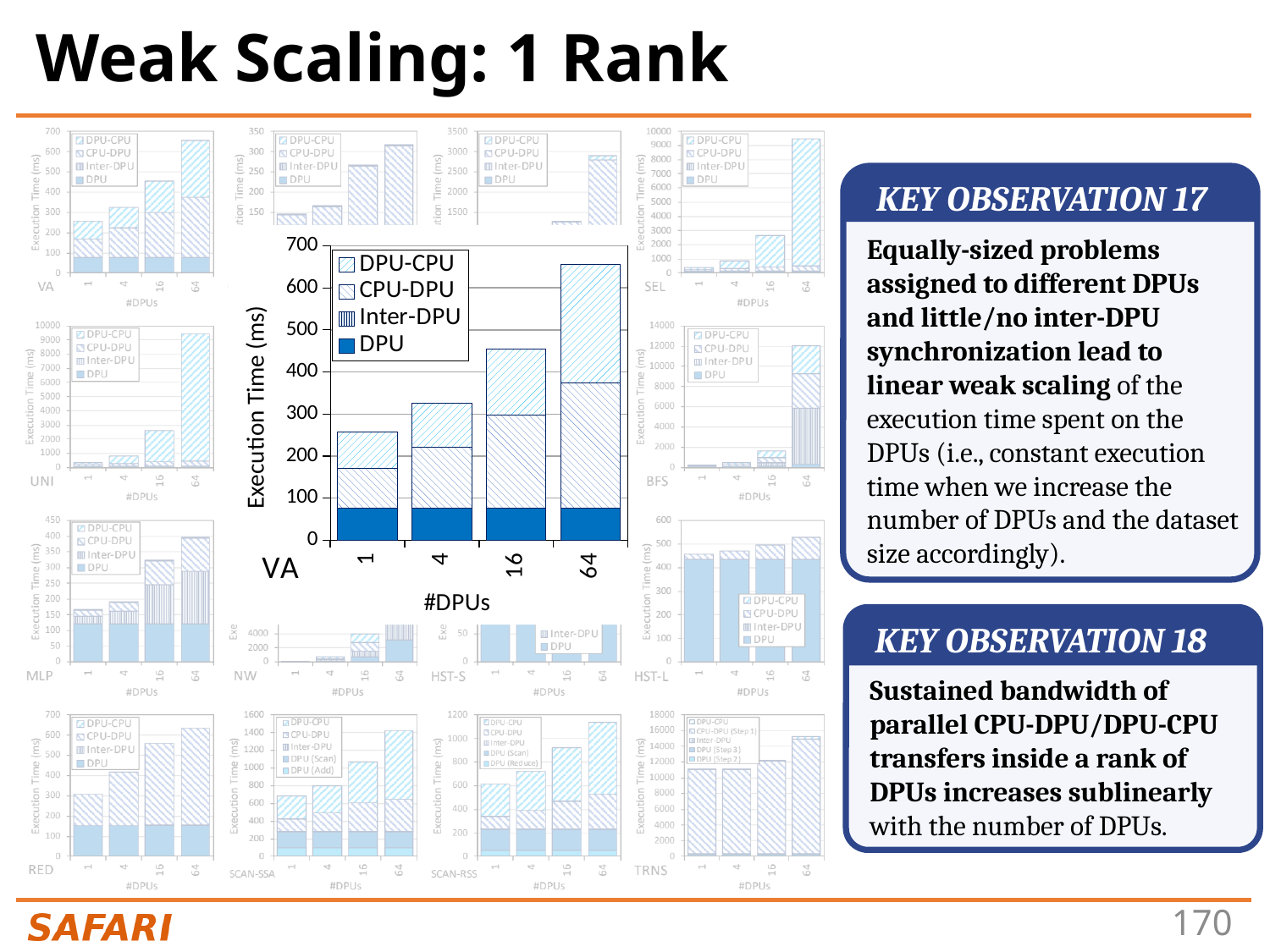
In the enlarged VA chart, what kind of chart is shown? stacked bar chart In the enlarged VA chart, does the total execution time rise or fall as the number of DPUs increases from 1 to 64? rise In the enlarged VA chart, what is the label of the y axis? Execution Time (ms) In the enlarged VA chart, is the total execution time for 16 DPUs greater or less than 400? greater In the enlarged VA chart, how many series does the legend list? 4 In the enlarged VA chart, which #DPUs category has the highest total execution time? 64 In the enlarged VA chart, which has the larger total execution time, 16 DPUs or 64 DPUs? 64 DPUs In the enlarged VA chart, which legend entry is drawn as a solid dark blue fill? DPU In the enlarged VA chart, how many #DPUs categories are plotted on the x axis? 4 In the enlarged VA chart, which #DPUs category has the lowest total execution time? 1 In the enlarged VA chart, is the total execution time for 1 DPU greater or less than 300? less In the enlarged VA chart, is the total execution time for 64 DPUs greater or less than 600? greater